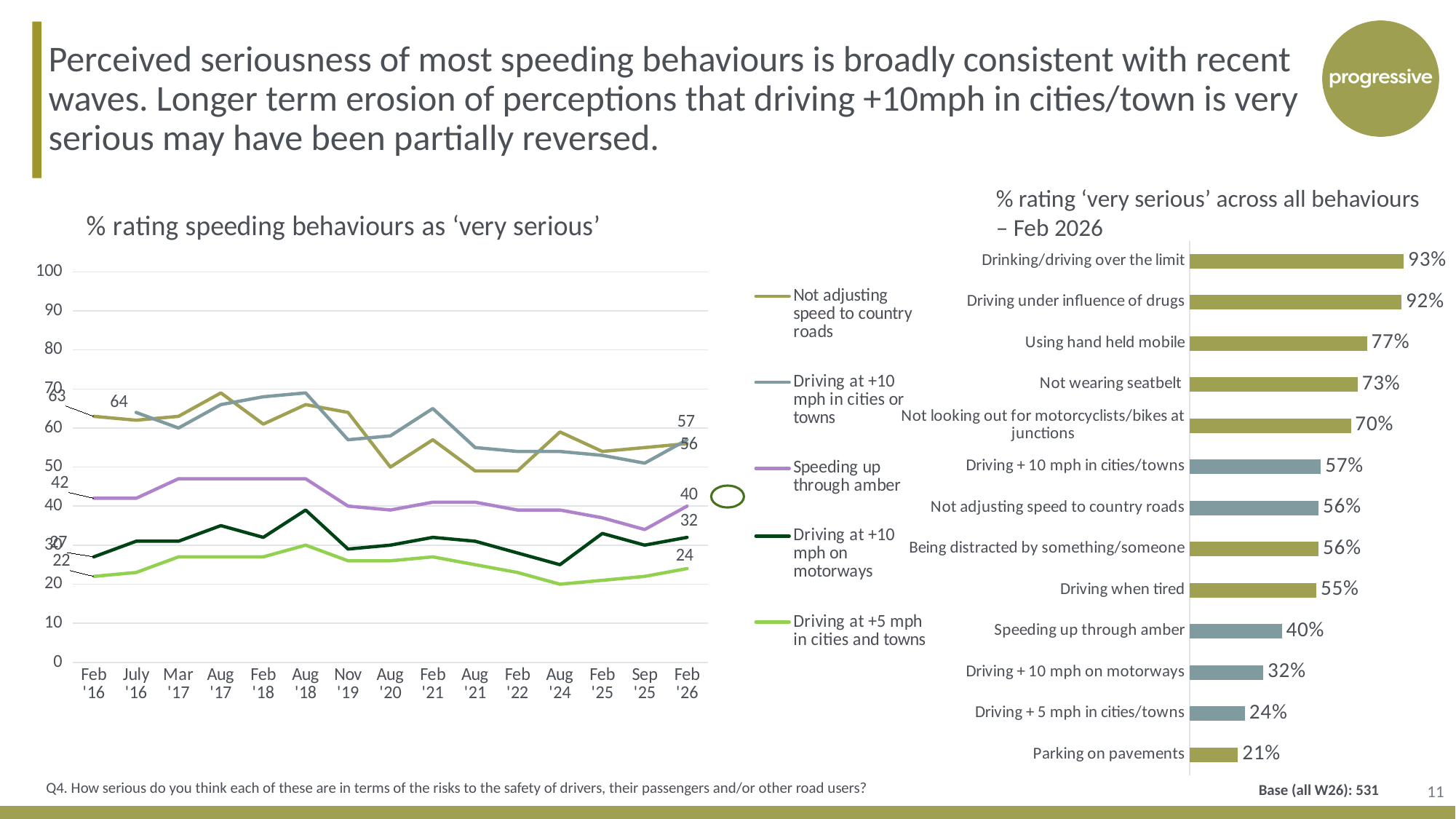
What kind of chart is the right-hand chart, '% rating ‘very serious’ across all behaviours – Feb 2026'? Bar chart In the left-hand line chart, is the value for 'Not adjusting speed to country roads' at Aug '17 greater or less than 60? greater In the left-hand line chart, what is the Feb '26 value for 'Speeding up through amber'? 40 How many time points are shown on the x axis of the left-hand line chart? 15 In the right-hand chart (Feb 2026), which behaviour has the lowest percentage rating it 'very serious'? Parking on pavements In the left-hand line chart, what is the Feb '26 value for 'Driving at +5 mph in cities and towns'? 24 How many behaviours are listed in the right-hand chart (Feb 2026)? 13 In the right-hand chart (Feb 2026), what is the difference in percentage points between 'Not wearing seatbelt' and 'Speeding up through amber'? 33 percentage points In the right-hand chart (Feb 2026), which behaviour has the highest percentage rating it 'very serious'? Drinking/driving over the limit How many series does the legend of the left-hand line chart '% rating speeding behaviours as ‘very serious’' list? 5 In the right-hand chart (Feb 2026), what percentage rate 'Using hand held mobile' as very serious? 77% In the right-hand chart (Feb 2026), which is larger: 'Driving when tired' or 'Driving + 10 mph on motorways'? Driving when tired